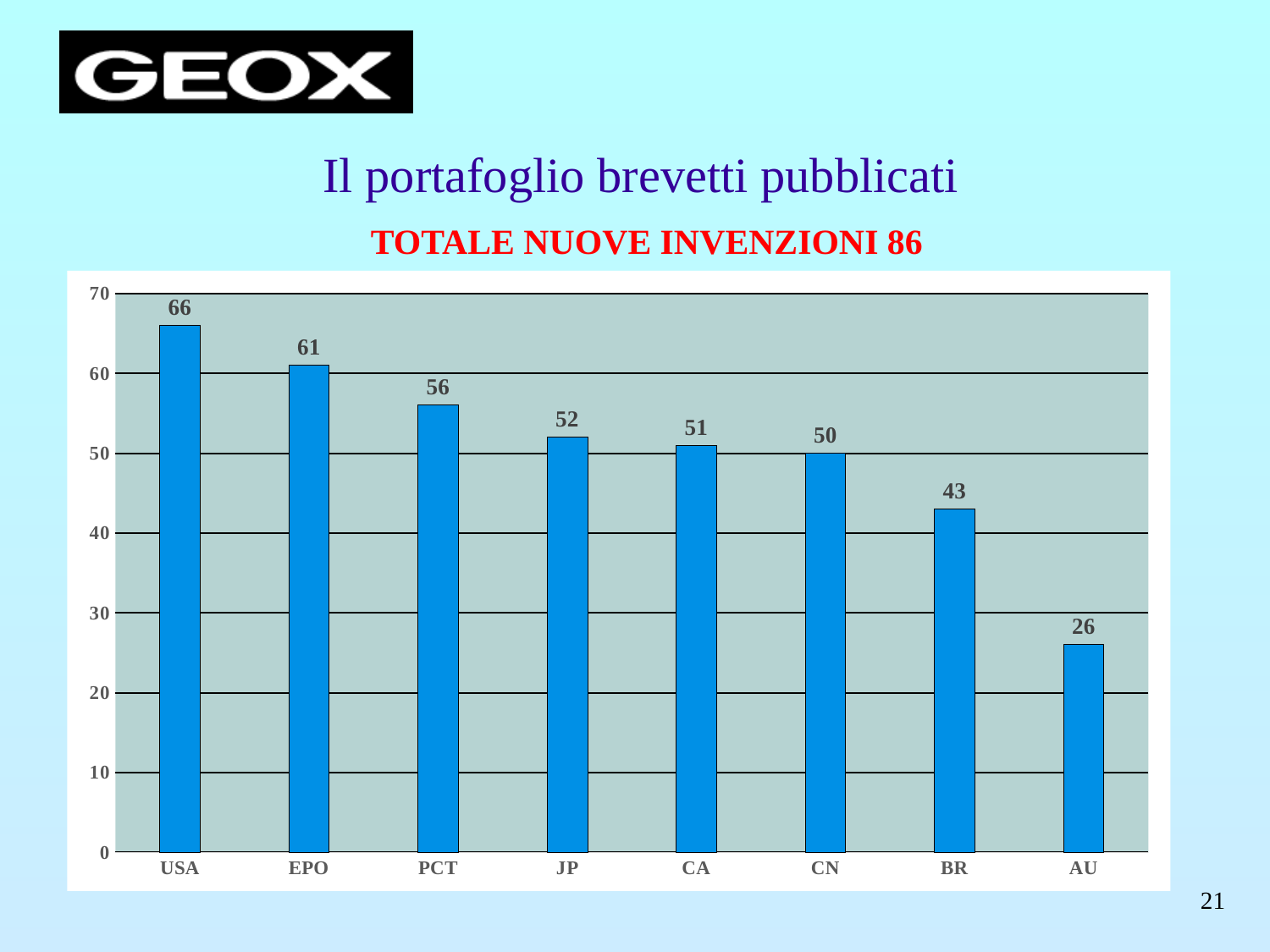
What is the value for USA? 66 Which category has the lowest value? AU What is the value for JP? 52 What is the difference between the values for EPO and PCT? 5 Which category has the highest value? USA Do the values rise or fall from left to right along the x axis? fall What is the value for BR? 43 How many categories are shown on the x axis? 8 What is the difference between the values for USA and AU? 40 Which is larger, the value for CN or the value for BR? CN Is the value for AU greater or less than 30? less What kind of chart is shown on the slide? bar chart